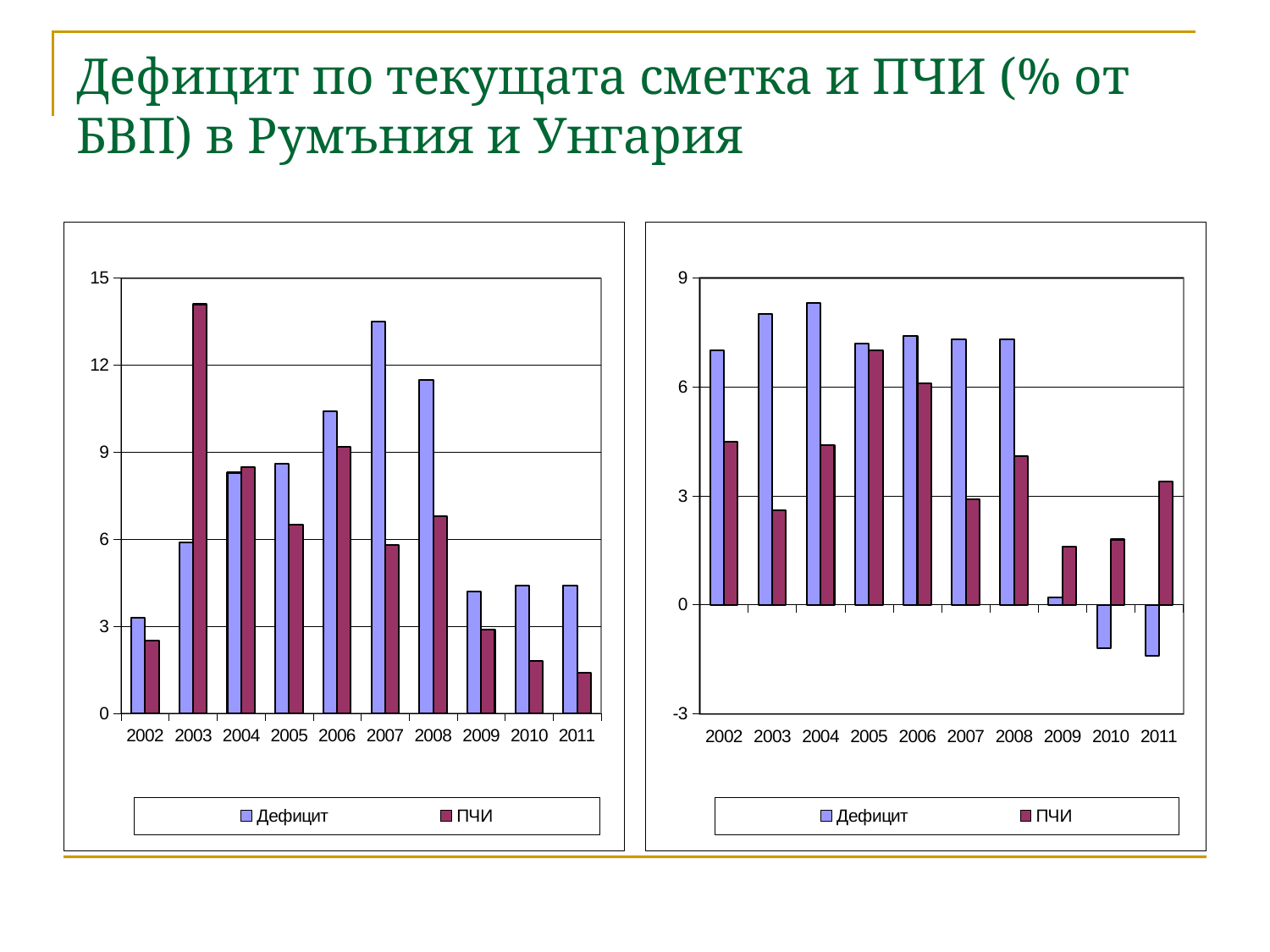
In the right chart, which year has the highest ПЧИ value? 2005 In the left chart, which year has the highest Дефицит value? 2007 In the right chart, in how many years is the Дефицит value below 0? 2 What kind of chart is the left chart on the slide? bar chart In the left chart, which year has the highest ПЧИ value? 2003 How many series does the legend of the right chart list? 2 How many years are shown on the x axis of the left chart? 10 In the right chart, which is larger in 2002: Дефицит or ПЧИ? Дефицит In the right chart, is the ПЧИ value for 2003 greater or less than 3? less In the left chart, which year has the lowest ПЧИ value? 2011 In the left chart, which is larger in 2003: Дефицит or ПЧИ? ПЧИ In the left chart, is the Дефицит value for 2007 greater or less than 12? greater